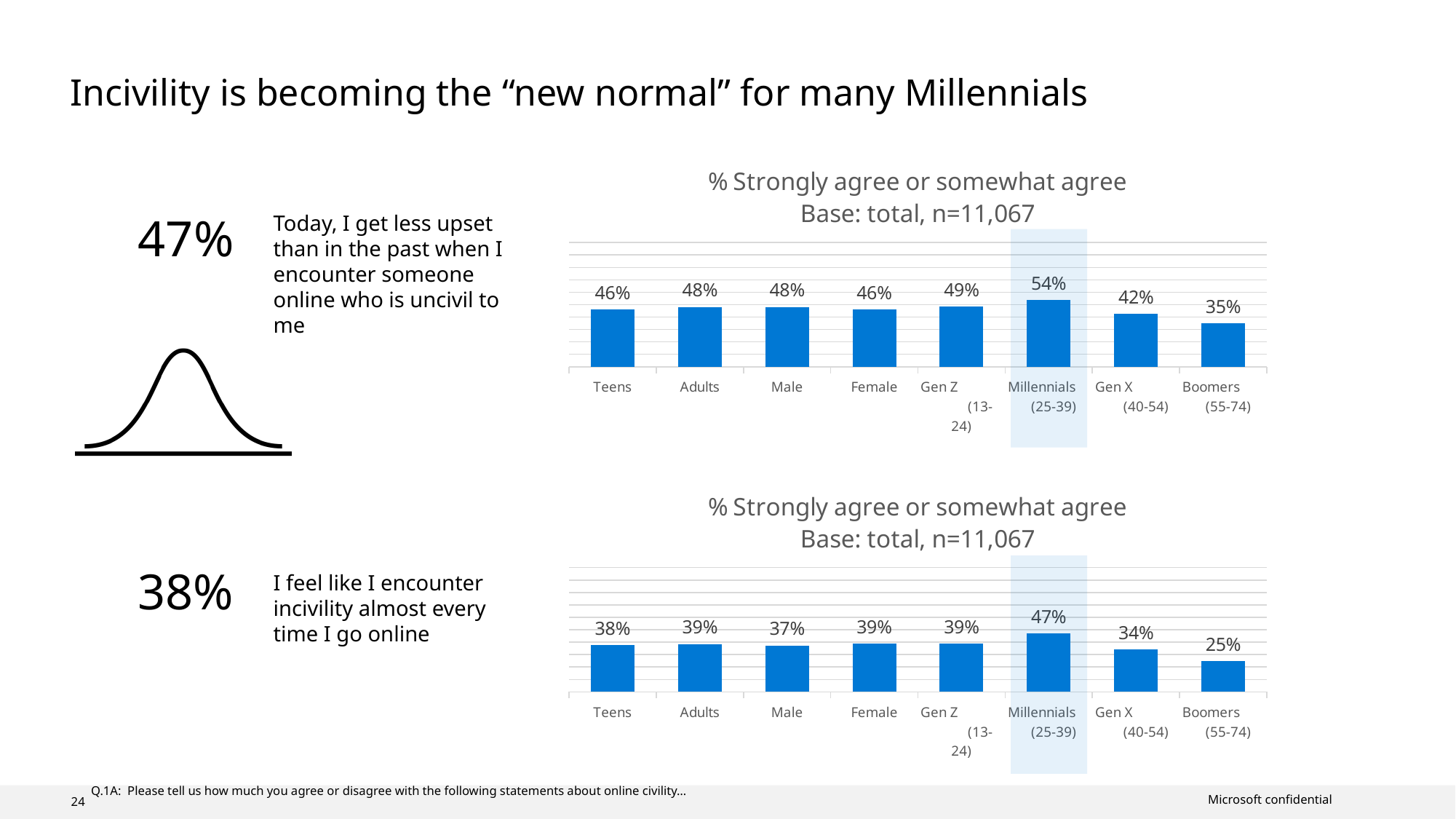
What type of chart is the bottom chart? Bar chart In the top chart, what percentage of Millennials (25-39) strongly or somewhat agree that they get less upset than in the past when encountering someone uncivil online? 54% In the bottom chart, which is larger: the value for Male or the value for Female? Female In the bottom chart, which group has the lowest value? Boomers (55-74) In the bottom chart, what is the difference between the Millennials (25-39) value and the Gen X (40-54) value? 13 percentage points In the top chart, what is the difference between the Millennials (25-39) value and the Boomers (55-74) value? 19 percentage points How many groups are shown on the x axis of the top chart? 8 What base size is stated in the title of the top chart? n=11,067 In the top chart, what is the value for Boomers (55-74)? 35% In the bottom chart, what is the value for Gen X (40-54)? 34% In the bottom chart, which group has the highest percentage agreeing they encounter incivility almost every time they go online? Millennials (25-39) In the top chart, which is larger: the value for Gen Z (13-24) or the value for Gen X (40-54)? Gen Z (13-24)